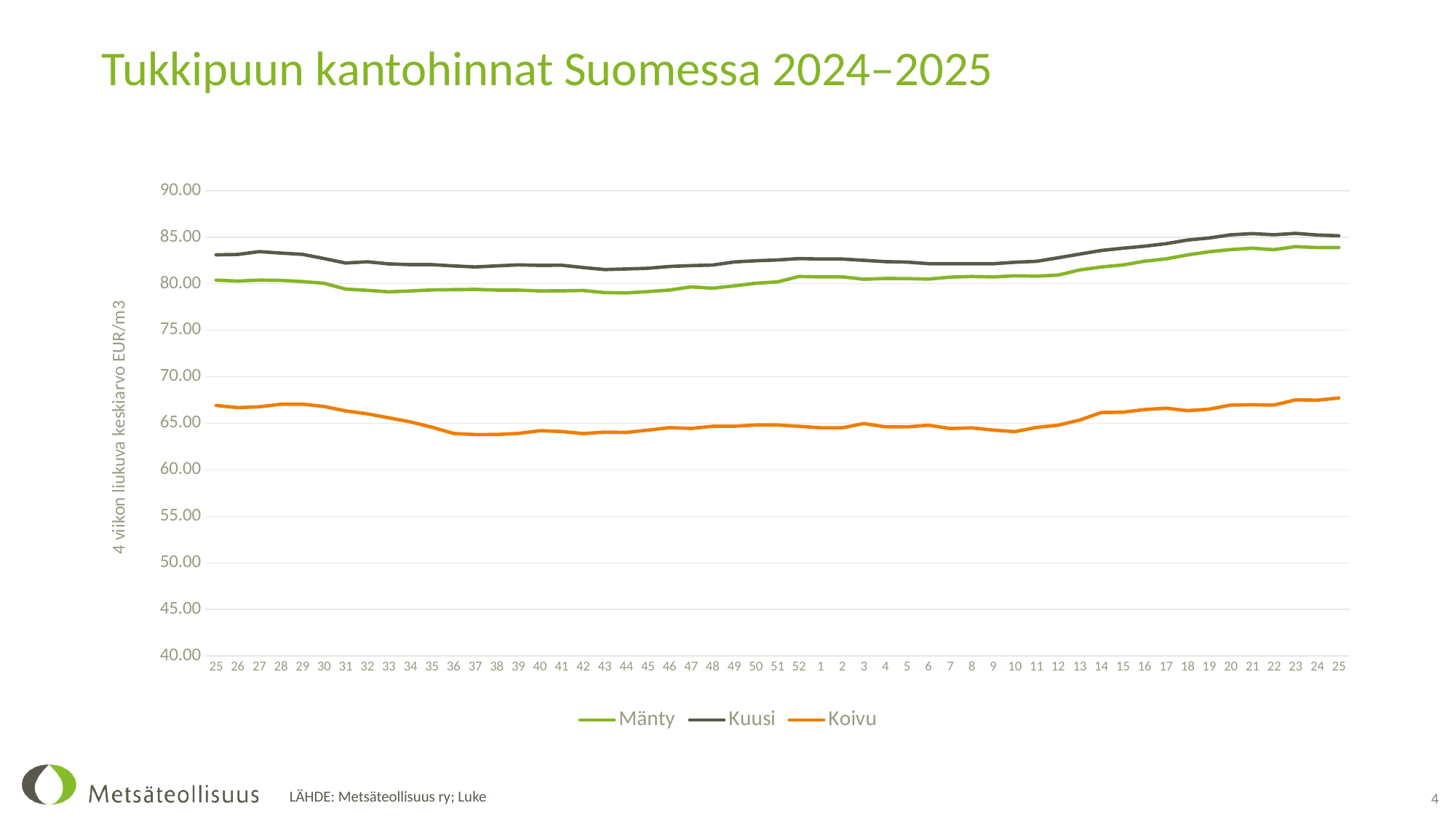
Is the value for Mänty at week 44 greater or less than 80.00? less How many weekly points are plotted along the x axis? 53 Which is larger at week 25 (the last point): the value for Mänty or the value for Koivu? Mänty Which series are listed in the legend? Mänty, Kuusi, Koivu How many series does the legend list? 3 Is the value for Koivu at week 36 greater or less than 65.00? less Which series has the highest values across the whole period? Kuusi Is the value for Kuusi at week 21 greater or less than 85.00? greater Does the Mänty series rise or fall between week 12 and week 20 of 2025? rise Which series has the lowest values across the whole period? Koivu What is the title of the chart on the slide? Tukkipuun kantohinnat Suomessa 2024–2025 What kind of chart is shown on the slide? line chart